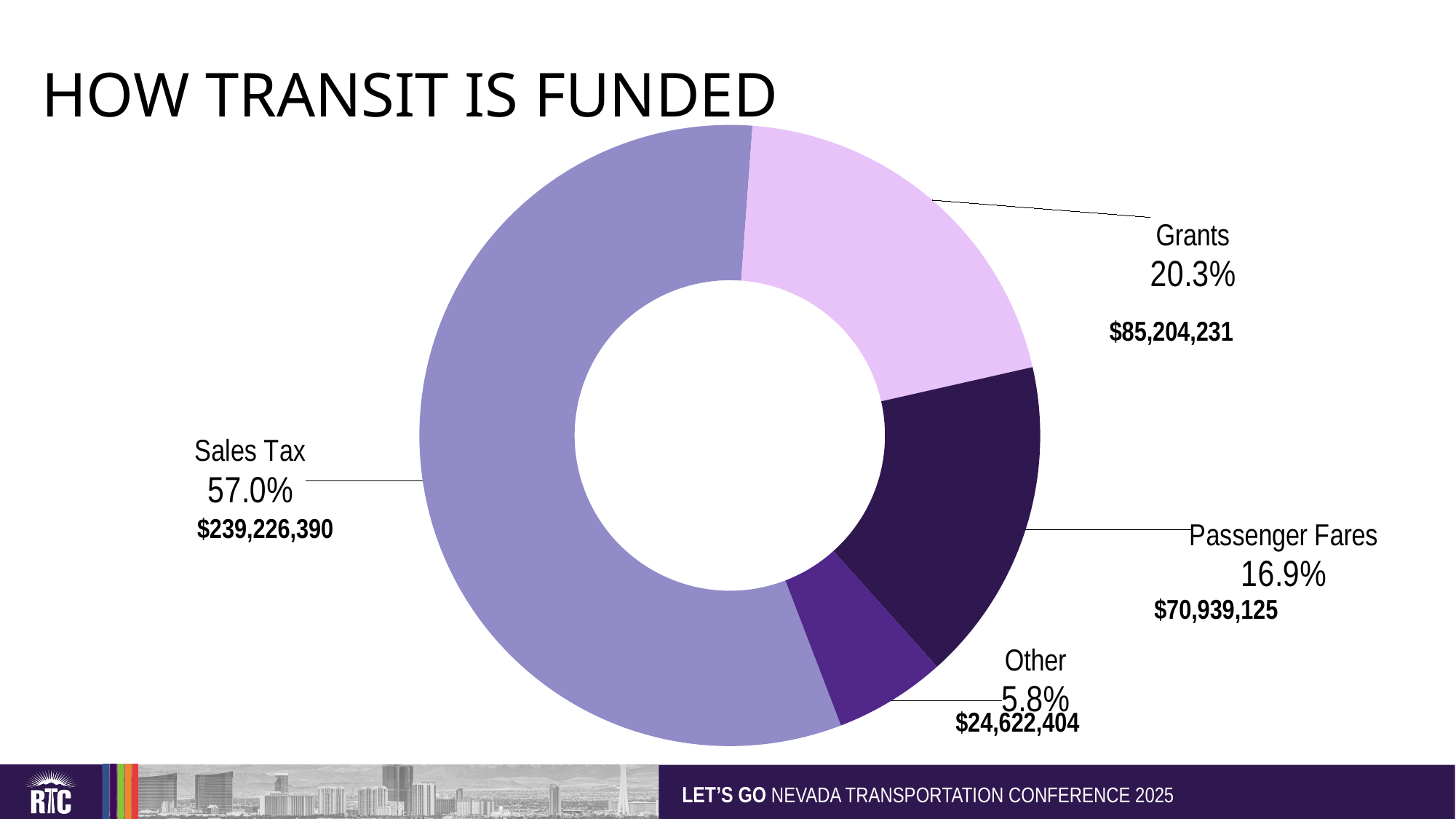
How many funding categories are shown in the chart? 4 What percentage of funding comes from Passenger Fares? 16.9% What is the title of the slide? HOW TRANSIT IS FUNDED Which is larger, Grants or Passenger Fares? Grants What kind of chart is shown on the slide? Pie chart (doughnut) What is the difference in percentage points between Grants and Passenger Fares? 3.4 Which funding source is the largest? Sales Tax What is the dollar amount shown for Grants? $85,204,231 Which funding source is the smallest? Other What is the dollar amount shown for Sales Tax? $239,226,390 What share of transit funding comes from Sales Tax? 57.0% What is the dollar amount shown for Other? $24,622,404